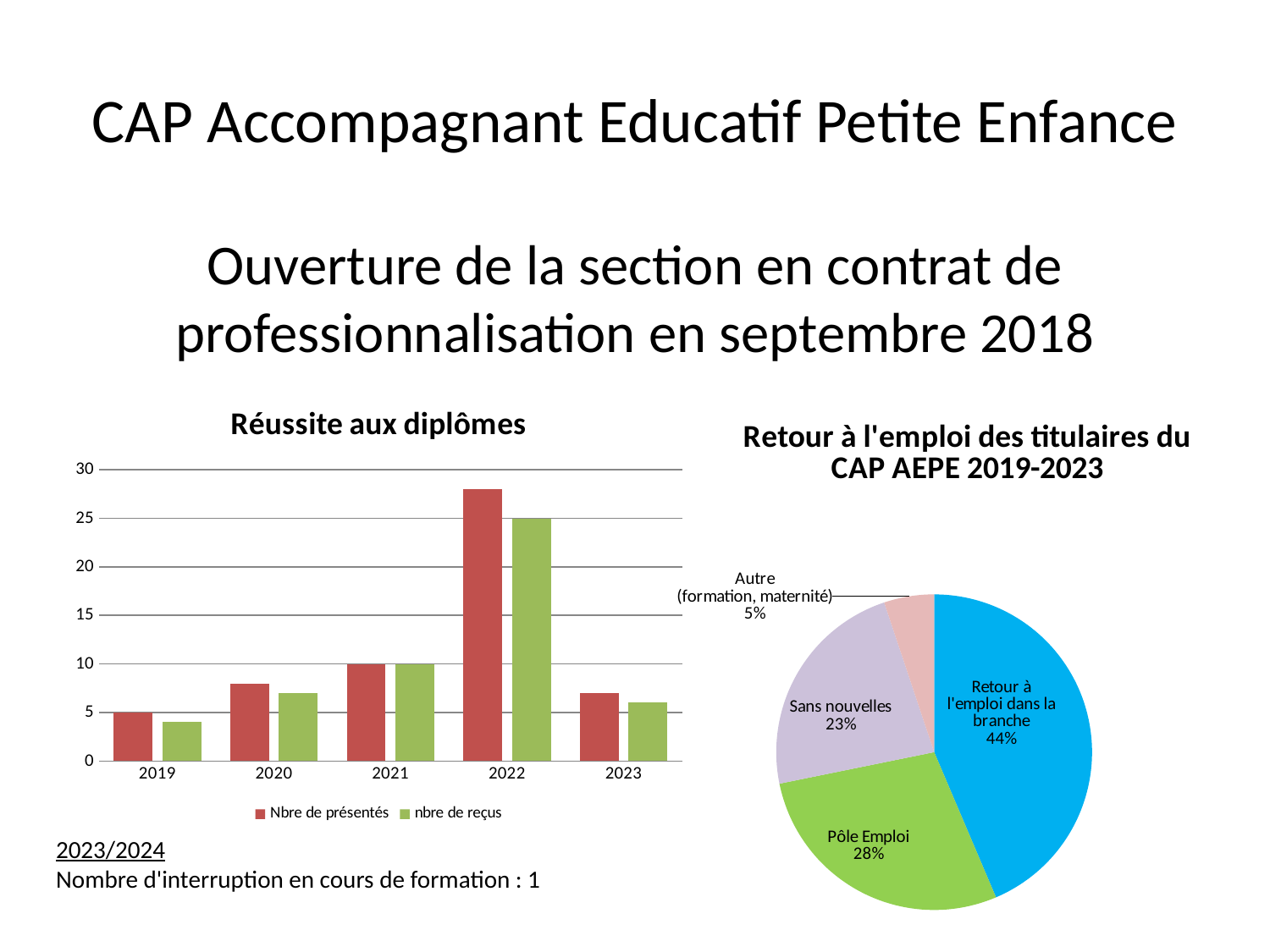
In the 'Réussite aux diplômes' chart, how many years are shown on the x axis? 5 In the pie chart 'Retour à l'emploi des titulaires du CAP AEPE 2019-2023', what share is 'Pôle Emploi'? 28% In the pie chart 'Retour à l'emploi des titulaires du CAP AEPE 2019-2023', what is the difference between 'Sans nouvelles' and 'Autre (formation, maternité)'? 18% In the 'Réussite aux diplômes' chart, which year has the lowest value for 'nbre de reçus'? 2019 In the 'Réussite aux diplômes' chart, which is larger in 2023: 'Nbre de présentés' or 'nbre de reçus'? Nbre de présentés In the 'Réussite aux diplômes' chart, is the value for 'Nbre de présentés' in 2020 greater or less than 10? less In the 'Réussite aux diplômes' chart, what is the value for 'nbre de reçus' in 2022? 25 In the pie chart 'Retour à l'emploi des titulaires du CAP AEPE 2019-2023', which slice is the largest? Retour à l'emploi dans la branche In the 'Réussite aux diplômes' chart, how many series does the legend list? 2 In the 'Réussite aux diplômes' chart, is the value for 'Nbre de présentés' in 2022 greater or less than 25? greater In the 'Réussite aux diplômes' chart, what kind of chart is it? bar chart In the 'Réussite aux diplômes' chart, which year has the highest value for 'Nbre de présentés'? 2022